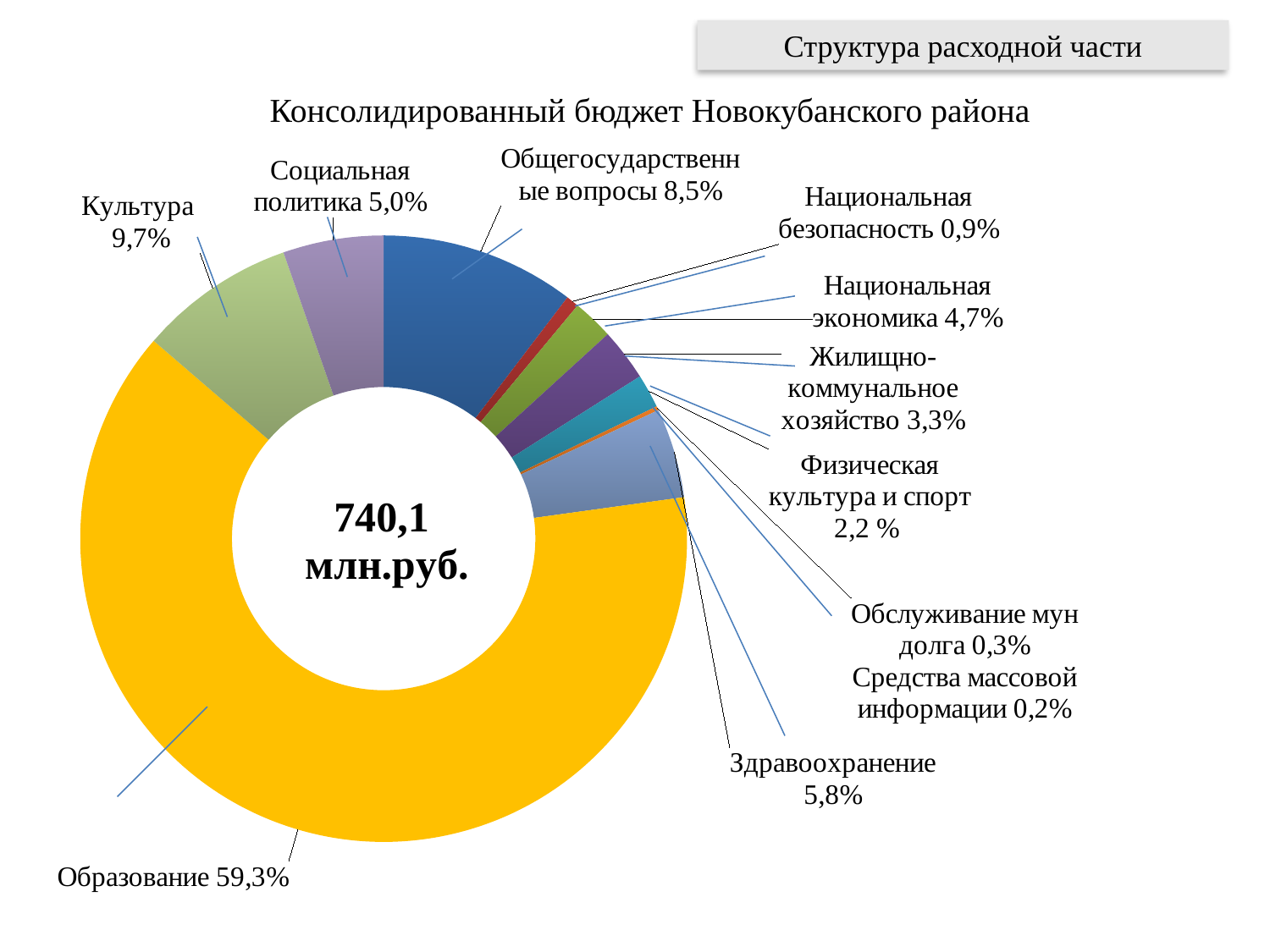
Which category has the largest share of the chart? Образование Which category has the smallest share of the chart? Средства массовой информации What total amount is printed in the centre of the chart? 740,1 млн.руб. What is the difference between the shares of Здравоохранение and Национальная безопасность? 4,9% What kind of chart is shown on the slide? Doughnut (pie) chart What is the value shown for Здравоохранение? 5,8% Which is larger, the share of Общегосударственные вопросы or the share of Национальная экономика? Общегосударственные вопросы What is the difference between the shares of Культура and Социальная политика? 4,7% How many categories are shown in the chart? 11 What is the title of the chart? Консолидированный бюджет Новокубанского района What is the value shown for Жилищно-коммунальное хозяйство? 3,3% What share of the chart does Образование account for? 59,3%